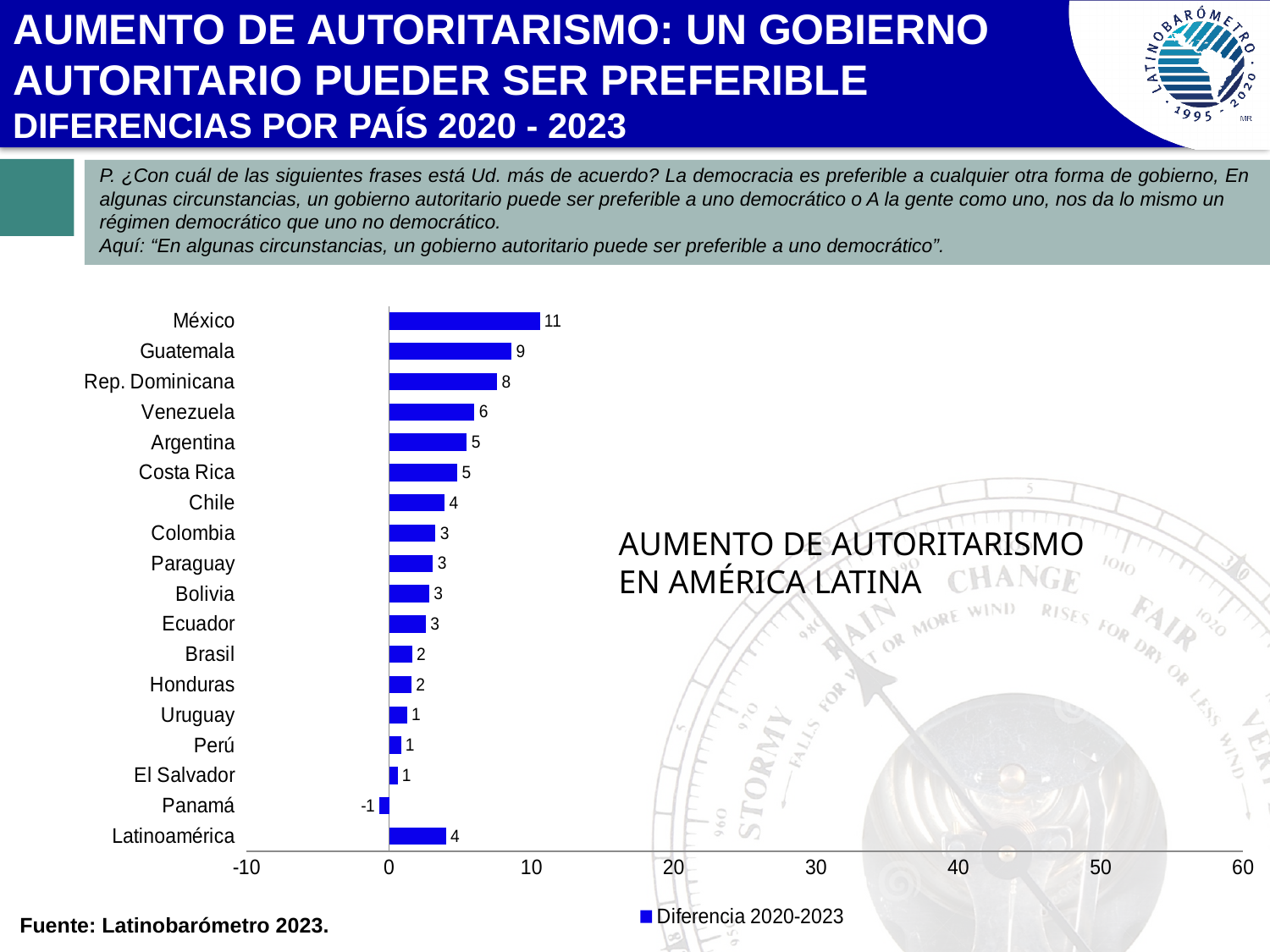
What is the legend entry for the series? Diferencia 2020-2023 What is the value for México? 11 What is the value for Latinoamérica? 4 What kind of chart is shown? bar chart What is the value for Panamá? -1 Which has a larger value, Venezuela or Chile? Venezuela What is the difference between the values for México and Guatemala? 2 Which country has the highest value? México How many series does the legend list? 1 How many categories are shown on the chart? 18 Which country has the lowest value? Panamá Is the value for Rep. Dominicana greater or less than 10? less